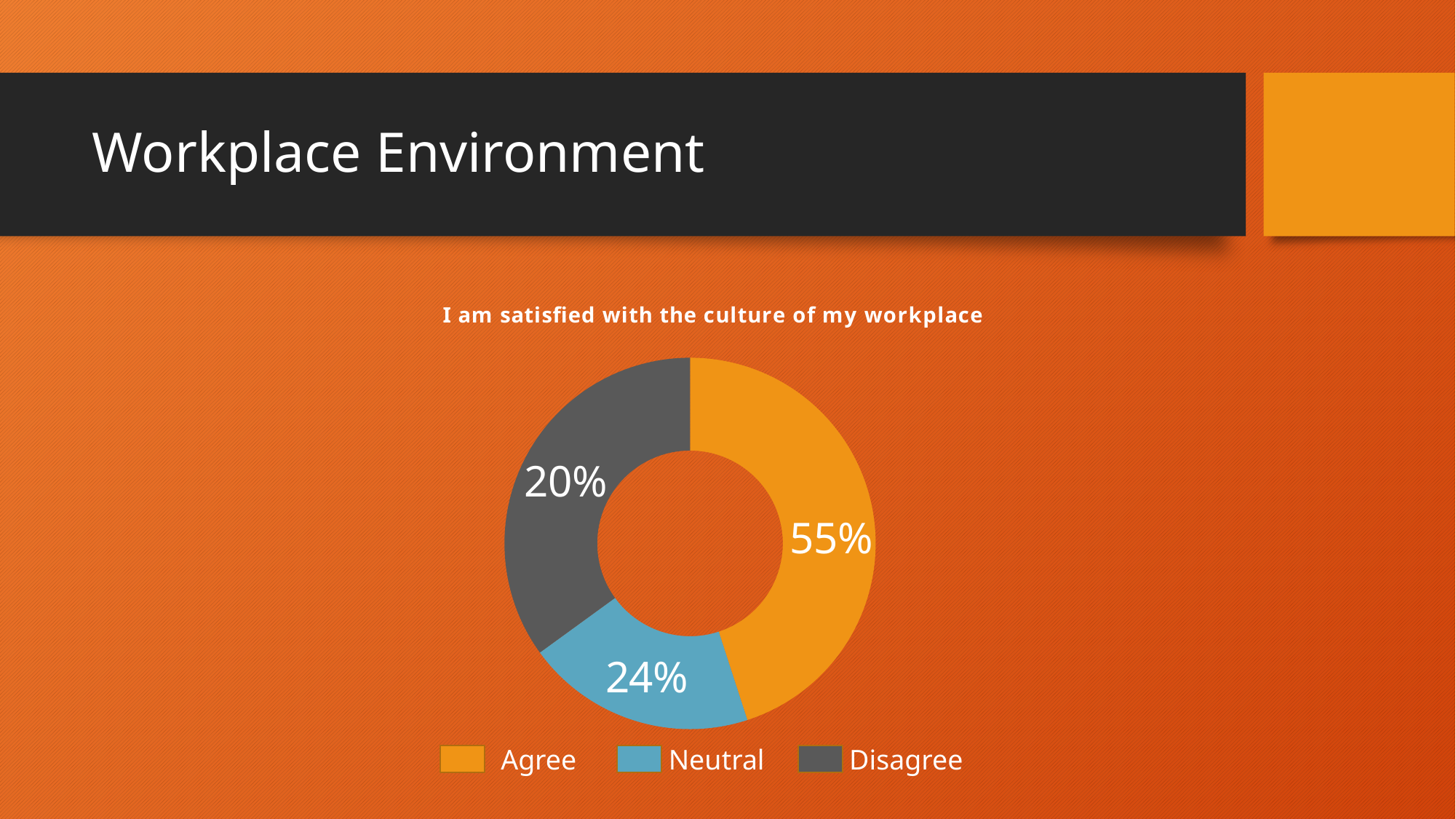
How many response categories are shown in the chart? 3 What is the title of the chart? I am satisfied with the culture of my workplace Which colour represents the Neutral category in the chart? Blue What percentage of respondents are neutral about being satisfied with the culture of their workplace? 24% What kind of chart is shown on the slide? Doughnut chart Which response category has the largest share of the chart? Agree What percentage of respondents disagree that they are satisfied with the culture of their workplace? 20% Which is larger, the Agree share or the Neutral share? Agree What percentage of respondents agree that they are satisfied with the culture of their workplace? 55% What is the difference in percentage points between the Neutral and Disagree shares? 4 What is the difference in percentage points between the Agree and Disagree shares? 35